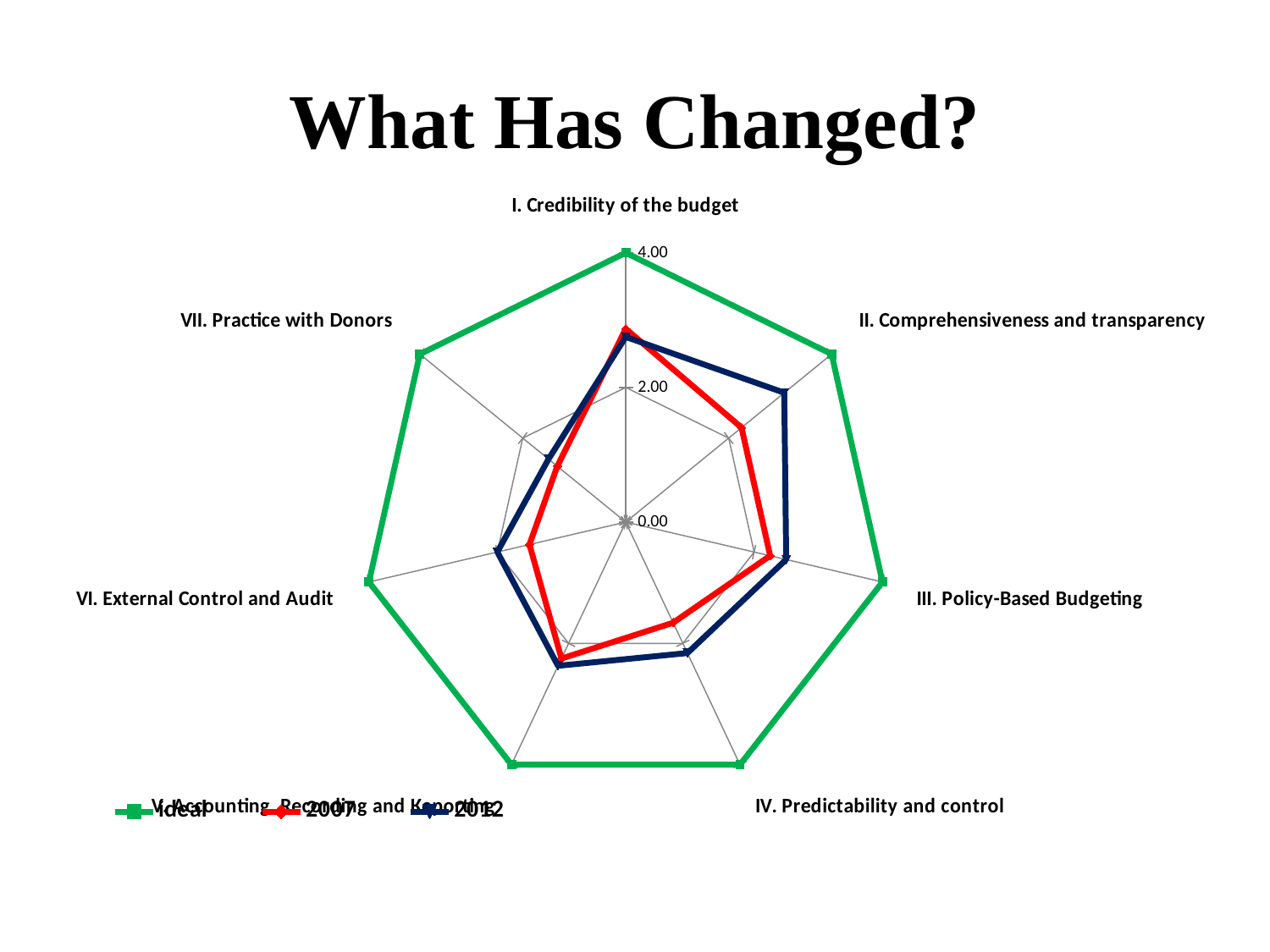
What is the value of the Ideal series for I. Credibility of the budget? 4.00 What colour is the line for the Ideal series? Green Is the 2007 value for VI. External Control and Audit greater or less than 2.00? less Is the 2007 value for VII. Practice with Donors greater or less than 2.00? less What is the value of the Ideal series for VI. External Control and Audit? 4.00 For II. Comprehensiveness and transparency, which is larger: the 2007 value or the 2012 value? 2012 How many categories (axes) does the radar chart have? 7 What kind of chart is shown on the slide? Radar chart Which series has the highest value for III. Policy-Based Budgeting? Ideal For IV. Predictability and control, which is larger: the 2007 value or the 2012 value? 2012 How many series does the legend list? 3 Is the 2012 value for II. Comprehensiveness and transparency greater or less than 2.00? greater